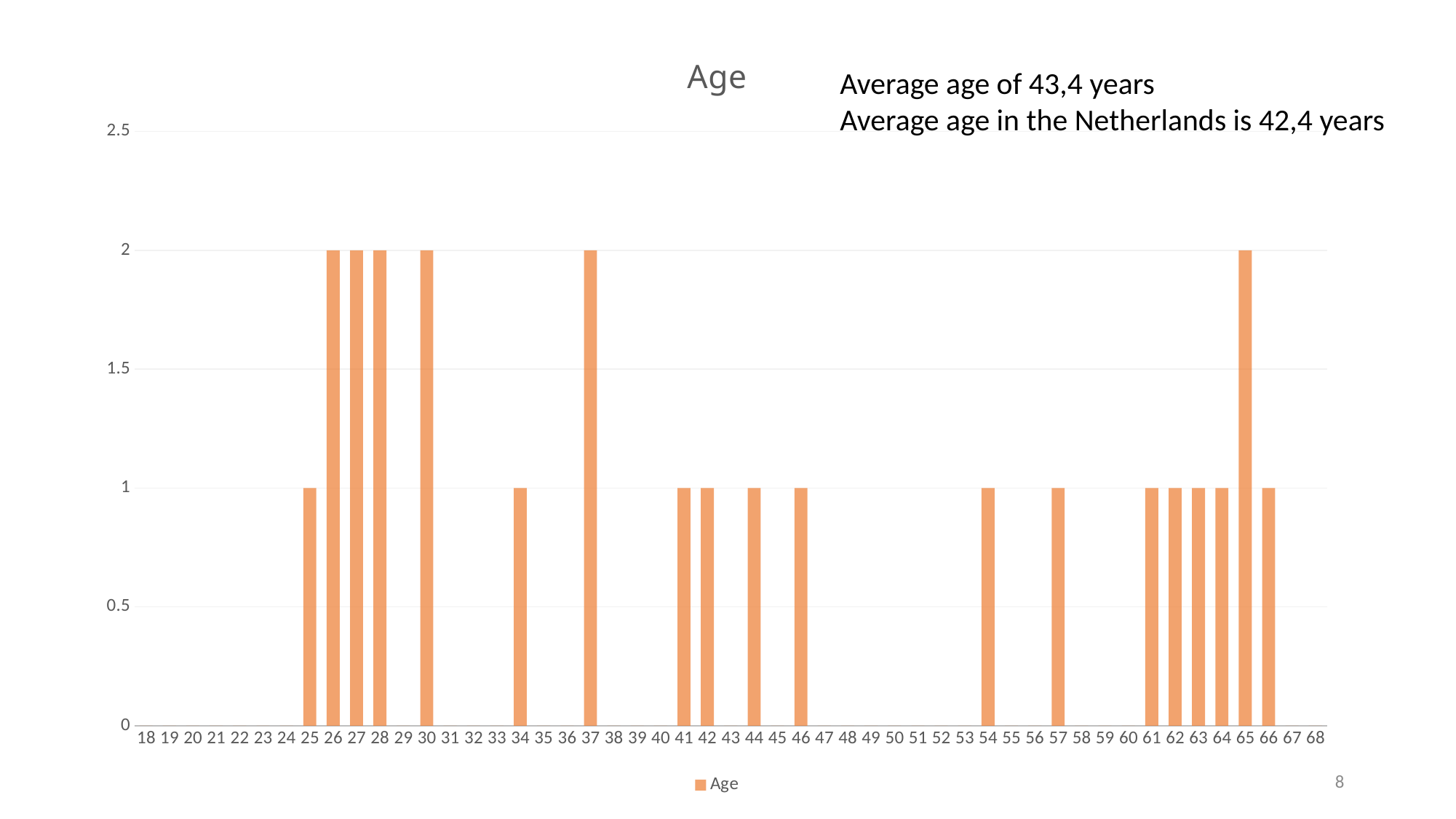
What is the highest value reached by any bar in the chart? 2 What is the value for age 26? 2 What is the value for age 34? 1 What is the difference between the value for age 30 and the value for age 46? 1 What kind of chart is shown on the slide? bar chart Which is larger, the value for age 37 or the value for age 41? age 37 How many series does the legend list? 1 What is the title of the chart? Age What is the value for age 65? 2 Is the value for age 28 greater or less than 1.5? greater What is the value for age 50? 0 How many age categories are shown on the x axis? 51